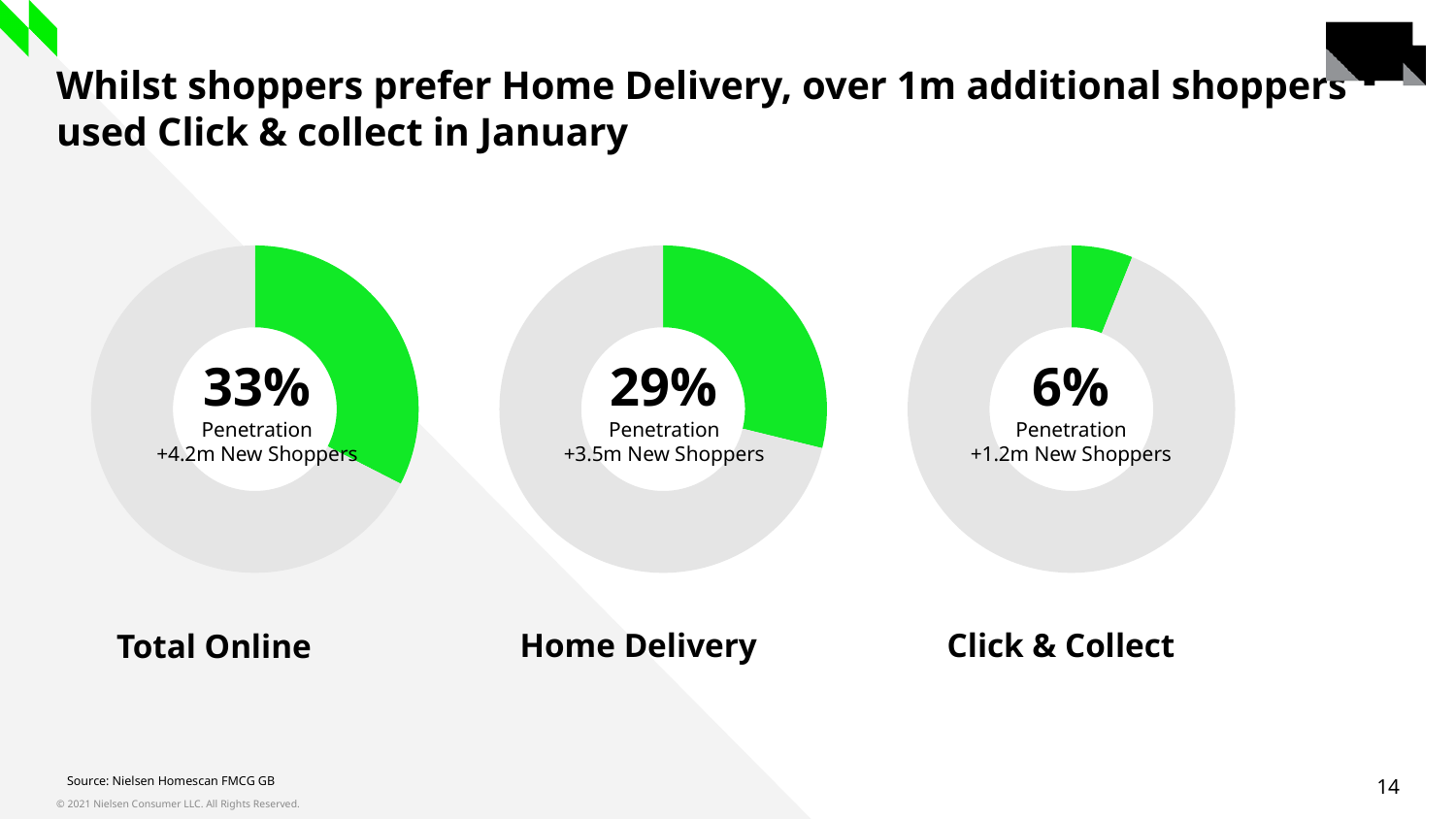
Which of the three donut charts shows the highest penetration? Total Online Which has the larger penetration, Home Delivery or Click & Collect? Home Delivery How many new shoppers does the Click & Collect chart report? +1.2m New Shoppers How many new shoppers does the Home Delivery chart report? +3.5m New Shoppers What penetration percentage is shown in the Total Online donut chart? 33% What is the difference in penetration between the Home Delivery chart and the Click & Collect chart? 23% Which of the three donut charts shows the lowest penetration? Click & Collect How many donut charts are shown on the slide? 3 What penetration percentage is shown in the Click & Collect donut chart? 6% What penetration percentage is shown in the Home Delivery donut chart? 29% What type of chart is used to show the penetration figures on this slide? Donut (pie) chart What is the difference in penetration between the Total Online chart and the Home Delivery chart? 4%